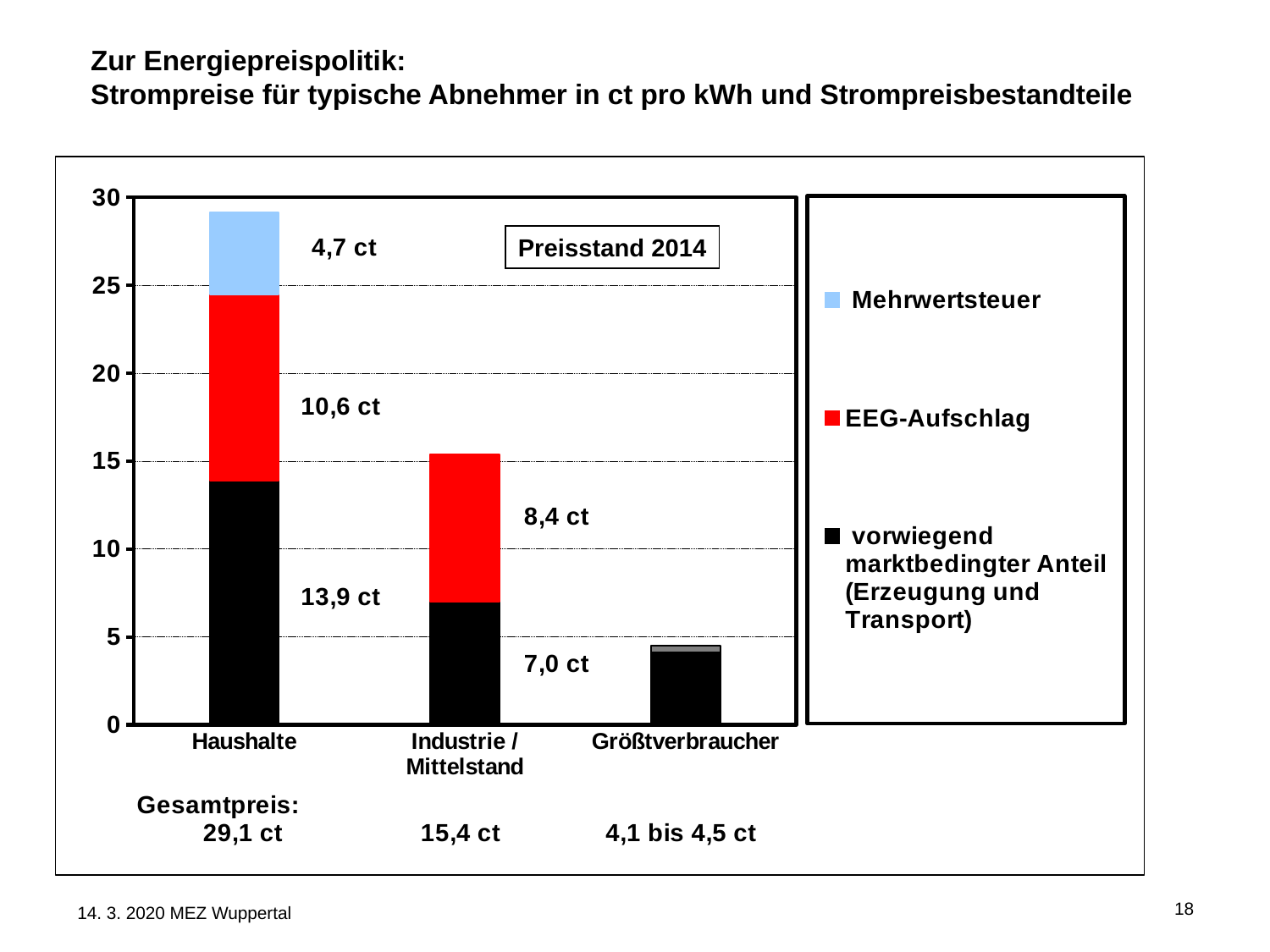
What is the EEG-Aufschlag value for Industrie / Mittelstand? 8,4 ct What is the Mehrwertsteuer value for Haushalte? 4,7 ct What is the difference between the EEG-Aufschlag for Haushalte and for Industrie / Mittelstand? 2,2 ct Which is larger for Industrie / Mittelstand: the EEG-Aufschlag or the vorwiegend marktbedingter Anteil? EEG-Aufschlag What kind of chart is shown on the slide? Stacked bar chart What is the vorwiegend marktbedingter Anteil value for Haushalte? 13,9 ct How many categories are shown on the x axis? 3 Which category has the lowest total electricity price? Größtverbraucher How many series does the legend list? 3 What is the Gesamtpreis shown for Industrie / Mittelstand? 15,4 ct Which category has the highest total electricity price? Haushalte What is the Gesamtpreis shown for Größtverbraucher? 4,1 bis 4,5 ct